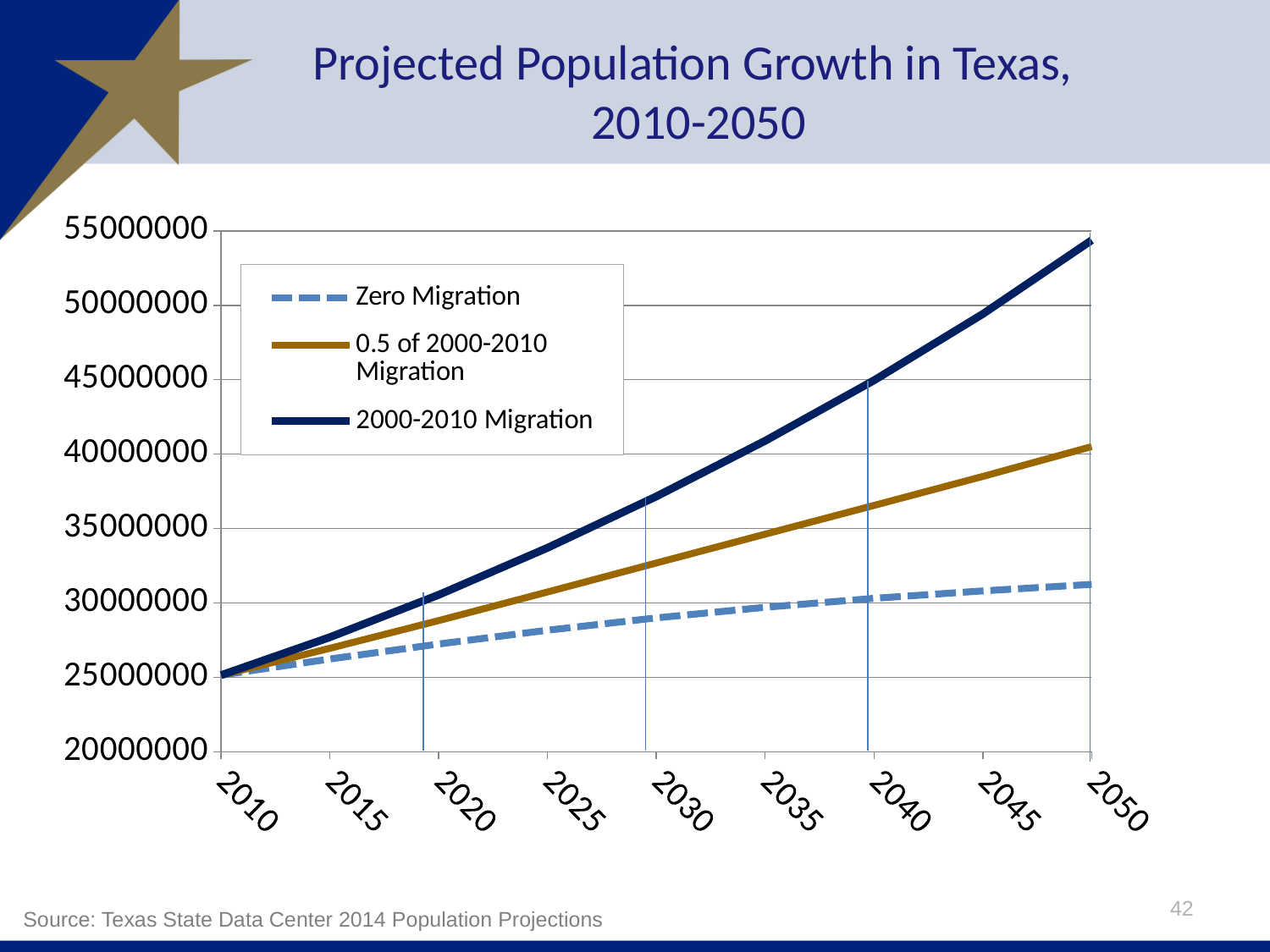
What kind of chart is shown on the slide? line chart Is the value for 2000-2010 Migration in 2050 greater or less than 50000000? greater In 2040, which is larger: the value for 2000-2010 Migration or the value for Zero Migration? 2000-2010 Migration How many year labels are shown along the x axis? 9 Is the value for 0.5 of 2000-2010 Migration in 2050 greater or less than 45000000? less Is the value for Zero Migration in 2030 greater or less than 30000000? less What is the title of the chart? Projected Population Growth in Texas, 2010-2050 Do the values for the 2000-2010 Migration series rise or fall from 2010 to 2050? rise Which series has the highest value in 2050? 2000-2010 Migration Which series has the lowest value in 2050? Zero Migration How many series does the legend list? 3